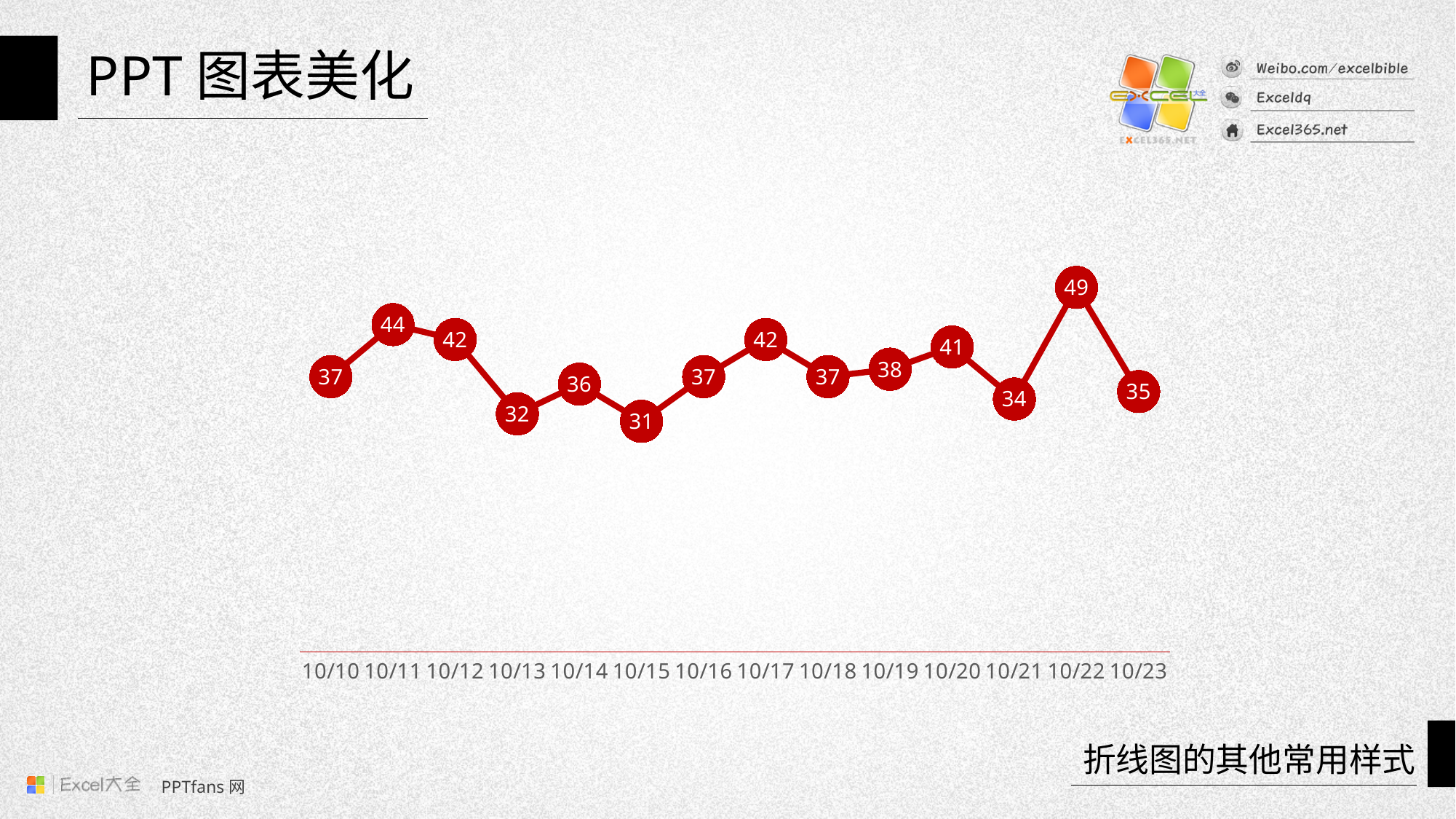
What is the difference between the values for 10/11 and 10/10? 7 How many data points are plotted on the chart? 14 Does the value rise or fall from 10/22 to 10/23? Fall Which is larger, the value for 10/13 or the value for 10/14? 10/14 Which date has the lowest value? 10/15 What is the value for 10/19? 38 What is the value for 10/22? 49 Which date has the highest value? 10/22 What kind of chart is shown on the slide? Line chart What is the value for 10/11? 44 What is the difference between the values for 10/22 and 10/21? 15 What is the value for 10/15? 31